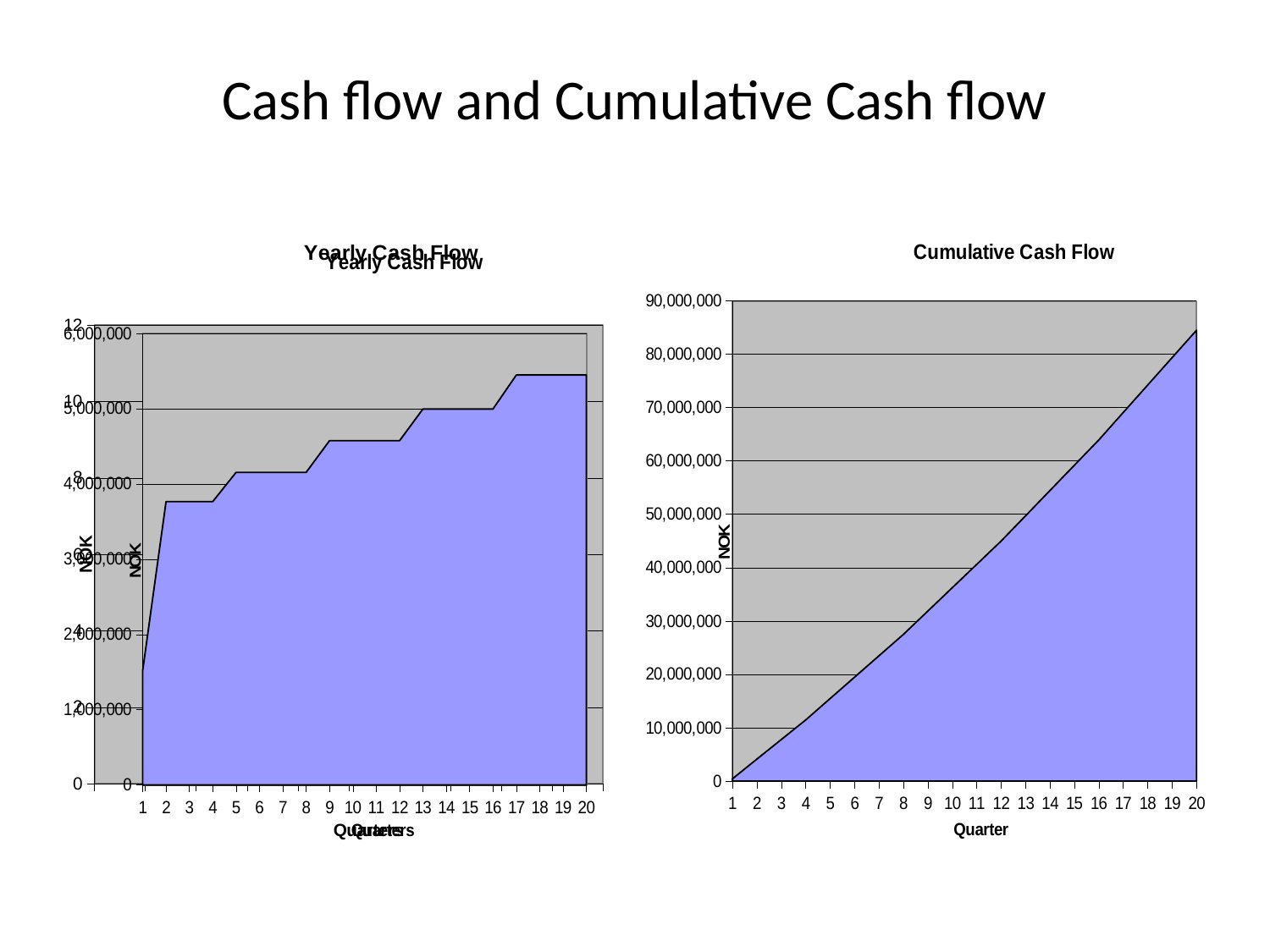
In the Yearly Cash Flow chart, which quarter has the lowest value? 1 In the Cumulative Cash Flow chart, which quarter has the highest value? 20 What kind of chart is the Cumulative Cash Flow chart? area chart In the Cumulative Cash Flow chart, which is larger, the value for quarter 5 or the value for quarter 15? quarter 15 In the Yearly Cash Flow chart, is the value for quarter 1 greater or less than 2,000,000? less What is the y-axis title of the Cumulative Cash Flow chart? NOK In the Cumulative Cash Flow chart, is the value for quarter 16 greater or less than 60,000,000? greater In the Yearly Cash Flow chart, is the value for quarter 20 greater or less than 5,000,000? greater In the Cumulative Cash Flow chart, do the values rise or fall as the quarter increases? rise In the Yearly Cash Flow chart, how many quarters are shown on the x axis? 20